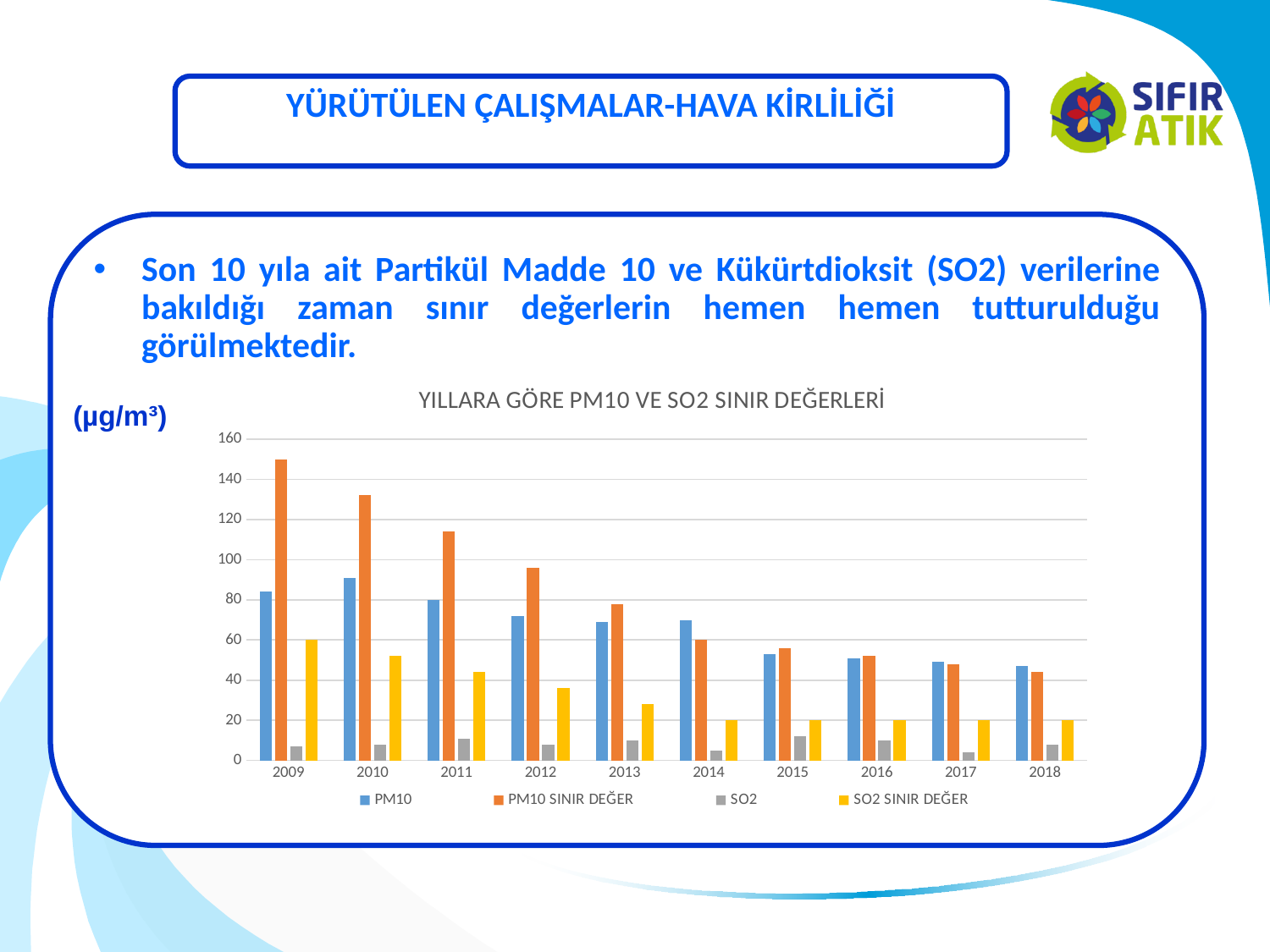
How many series does the legend of the chart list? 4 In 2009, which is larger: PM10 or PM10 SINIR DEĞER? PM10 SINIR DEĞER Is the PM10 value for 2010 greater or less than 80? greater Is the SO2 value for 2015 greater or less than 20? less What is the title of the chart? YILLARA GÖRE PM10 VE SO2 SINIR DEĞERLERİ Do the PM10 SINIR DEĞER values rise or fall from 2009 to 2018? fall What is the SO2 SINIR DEĞER value for 2018? 20 In which year is the PM10 SINIR DEĞER value highest? 2009 Is the PM10 SINIR DEĞER value for 2009 greater or less than 140? greater How many years are shown on the x axis of the chart? 10 What kind of chart is shown on the slide? bar chart In which year is the PM10 value highest? 2010